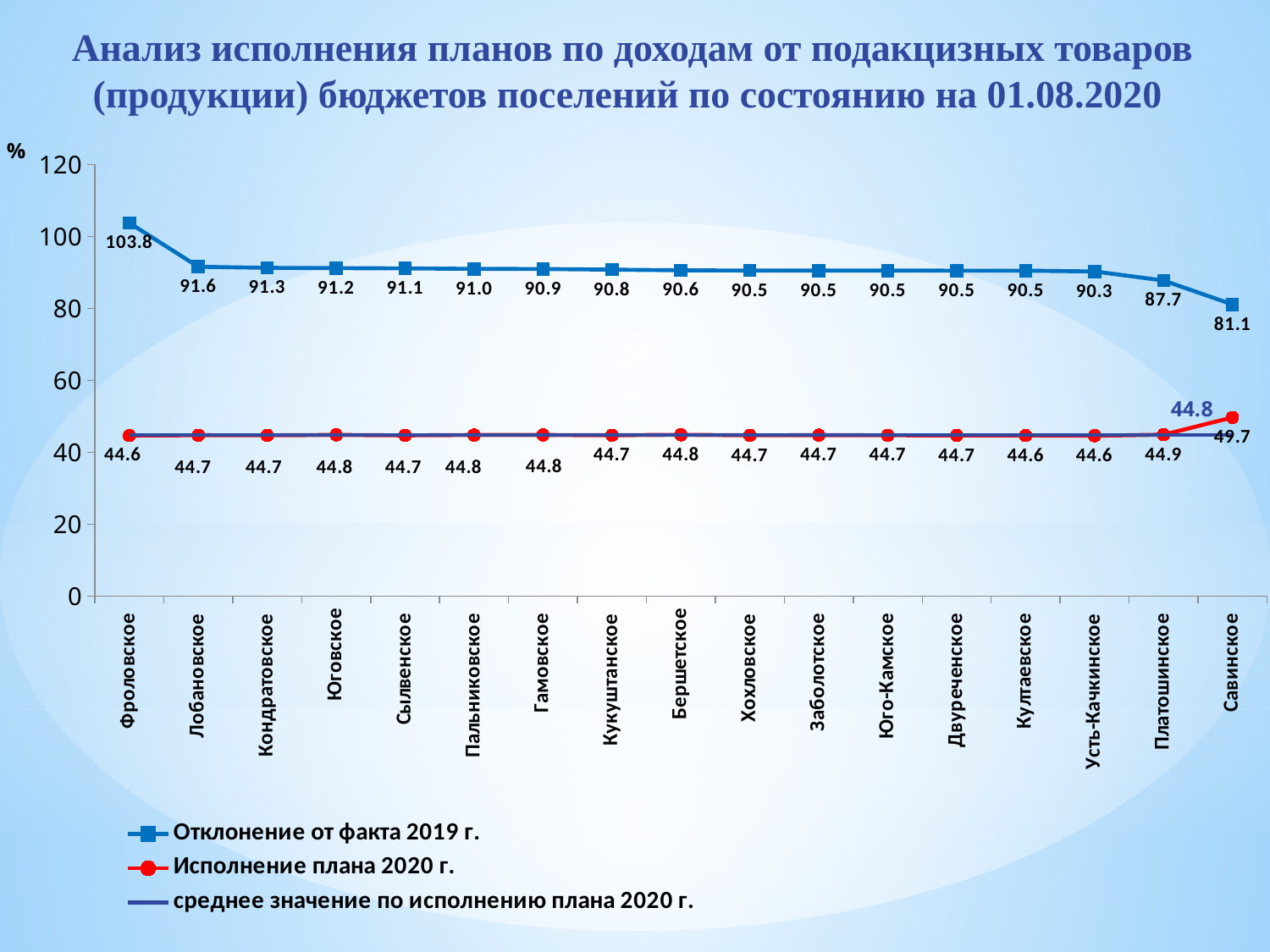
What kind of chart is shown on the slide? line chart How many settlements (categories) are plotted along the x axis? 17 How many series does the legend list? 3 What is the value of 'Отклонение от факта 2019 г.' for Фроловское? 103.8 What is the difference between the 'Отклонение от факта 2019 г.' values for Фроловское and Савинское? 22.7 Which settlement has the highest value for 'Отклонение от факта 2019 г.'? Фроловское Which has the larger 'Отклонение от факта 2019 г.' value, Лобановское or Платошинское? Лобановское What is the value of 'Отклонение от факта 2019 г.' for Савинское? 81.1 Which settlement has the lowest value for 'Отклонение от факта 2019 г.'? Савинское Does the 'Отклонение от факта 2019 г.' series generally rise or fall from left to right along the x axis? fall Which settlement has the highest value for 'Исполнение плана 2020 г.'? Савинское What is the value of 'Исполнение плана 2020 г.' for Савинское? 49.7